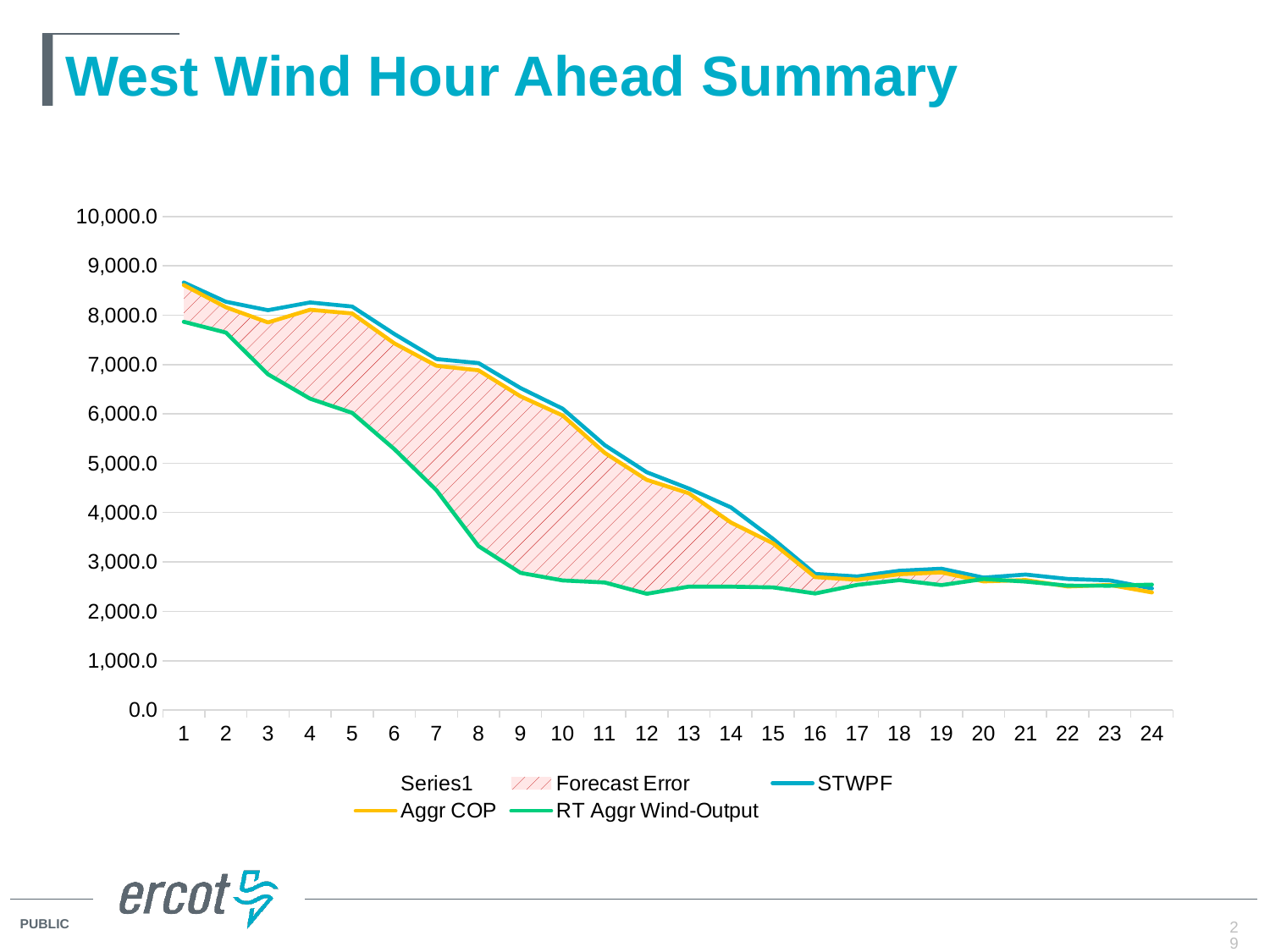
Is the STWPF value at hour 1 greater or less than 8,000.0? greater At hour 8, which is larger: STWPF or RT Aggr Wind-Output? STWPF How many hours (points) are shown along the x axis? 24 Is the RT Aggr Wind-Output value at hour 12 greater or less than 3,000.0? less What kind of chart is shown on the slide? line chart How many entries does the legend list? 5 What is the title of the slide containing the chart? West Wind Hour Ahead Summary Is the STWPF value at hour 10 greater or less than 5,000.0? greater Which legend entry is drawn with red hatching? Forecast Error At which hour is the STWPF value highest? 1 Does the STWPF line rise or fall from hour 1 to hour 16? fall